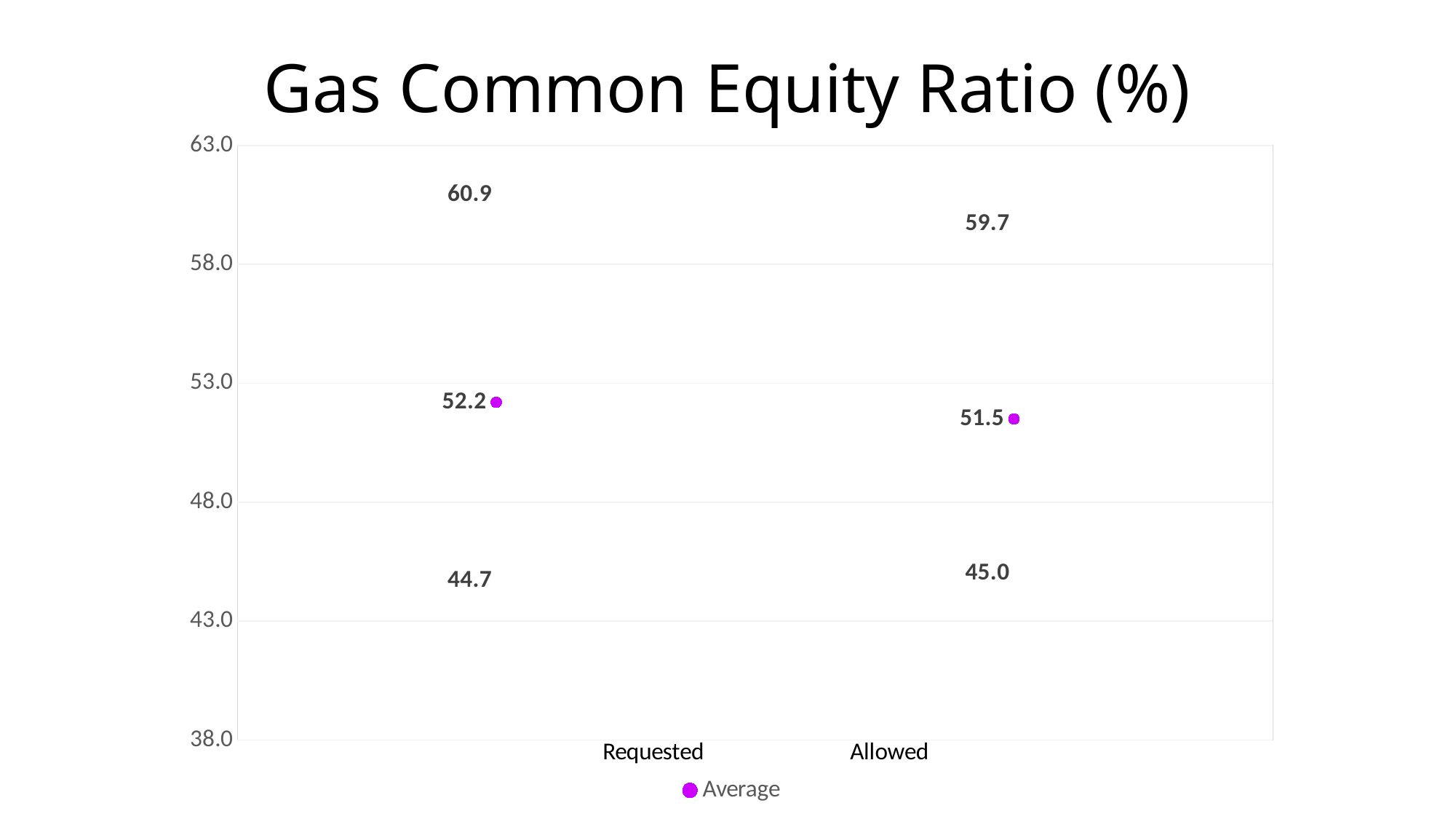
What colour are the Average markers? Magenta What is the Average value for Requested? 52.2 What is the difference between the Average values for Requested and Allowed? 0.7 What is the difference between the highest and lowest values labelled for Requested? 16.2 How many categories are shown on the x axis? 2 Which category has the higher Average value, Requested or Allowed? Requested What is the title of the chart? Gas Common Equity Ratio (%) What is the Average value for Allowed? 51.5 How many series does the legend list? 1 What is the lowest value labelled for Allowed? 45.0 What is the highest value labelled for Requested? 60.9 Is the Average value for Allowed greater or less than 53.0? less